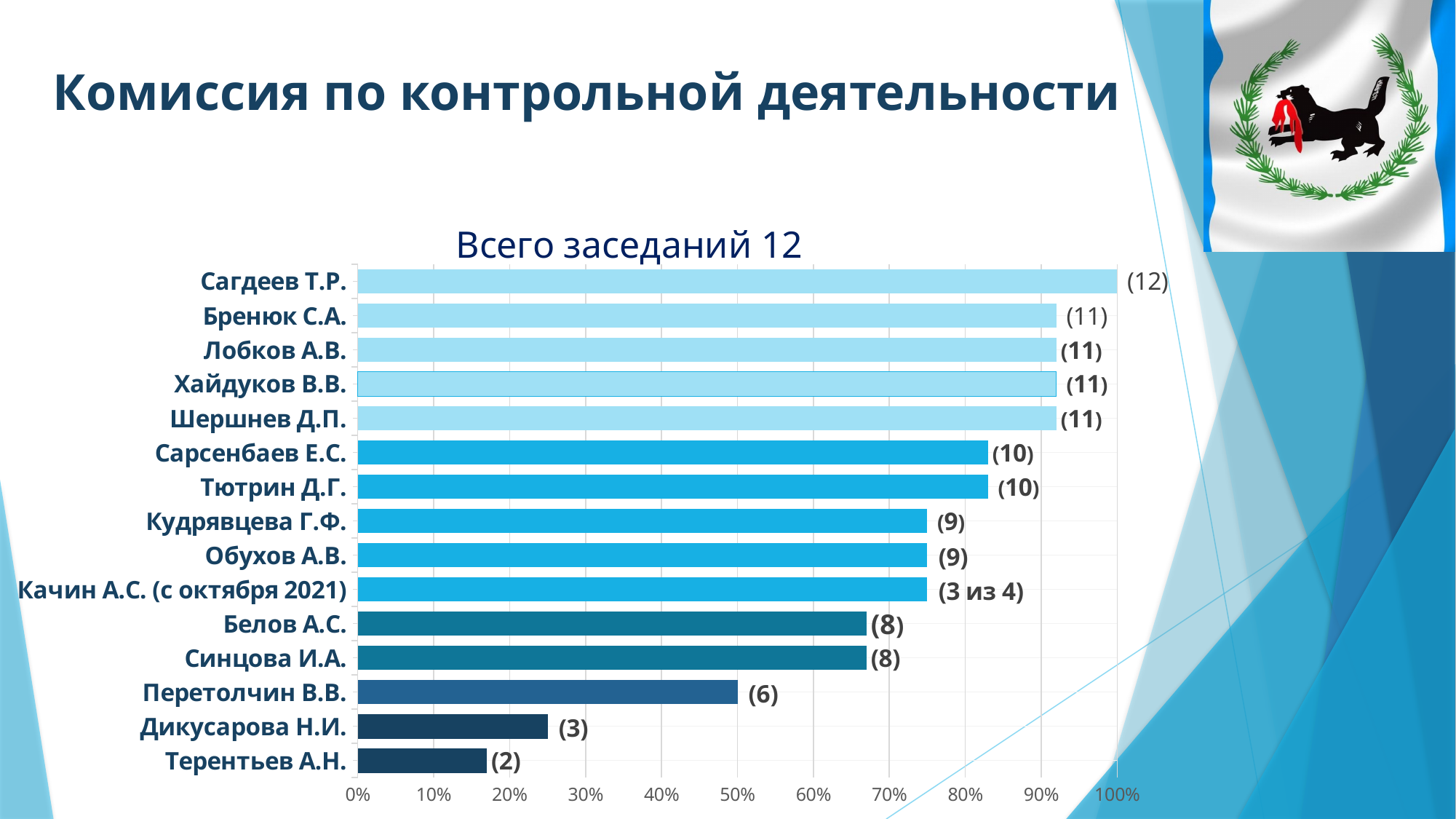
Which person has the lowest value in the chart? Терентьев А.Н. What kind of chart is shown on the slide? bar chart Is the value for Белов А.С. greater or less than 60%? greater What number is shown in the data label for Сагдеев Т.Р.? (12) What percentage does the bar for Перетолчин В.В. reach on the x axis? 50% Which person has the highest value in the chart? Сагдеев Т.Р. Which is larger, the value for Дикусарова Н.И. or the value for Синцова И.А.? Синцова И.А. What is the title of the chart? Всего заседаний 12 How many people (categories) are listed in the chart? 15 What number is shown in the data label for Перетолчин В.В.? (6) What number is shown in the data label for Терентьев А.Н.? (2) What is shown in the data label for Качин А.С. (с октября 2021)? (3 из 4)